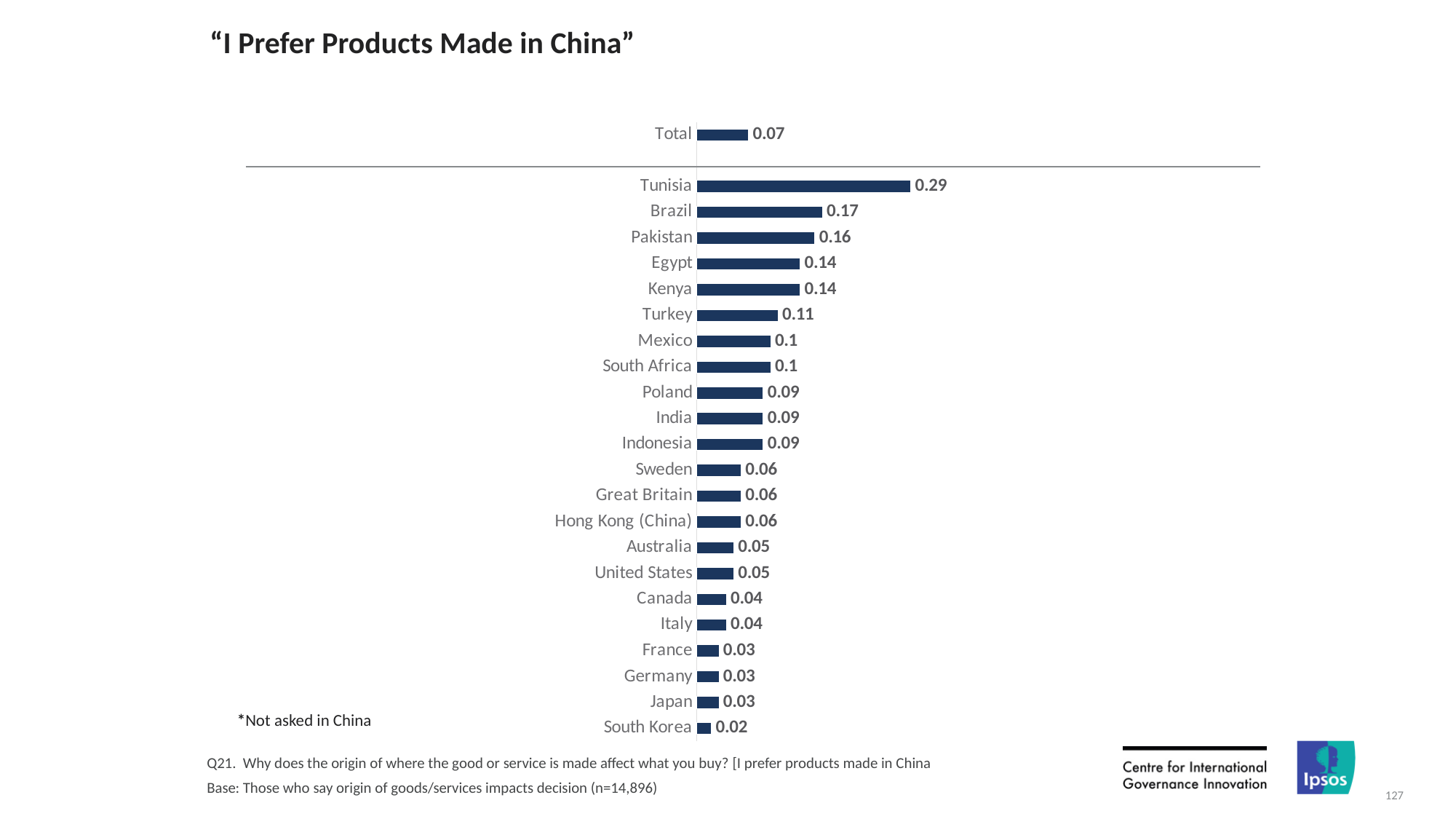
What is the value for Pakistan? 0.16 How many countries are listed below the Total bar? 22 Which has a larger value, Egypt or Mexico? Egypt Which country has the lowest value? South Korea What type of chart is shown on the slide? Bar chart What is the difference between the values for Tunisia and Brazil? 0.12 What is the difference between the values for Turkey and Canada? 0.07 What is the value for Hong Kong (China)? 0.06 Which country has the highest value? Tunisia What is the value for Tunisia? 0.29 What is the title of the chart? "I Prefer Products Made in China" What is the value for Total? 0.07